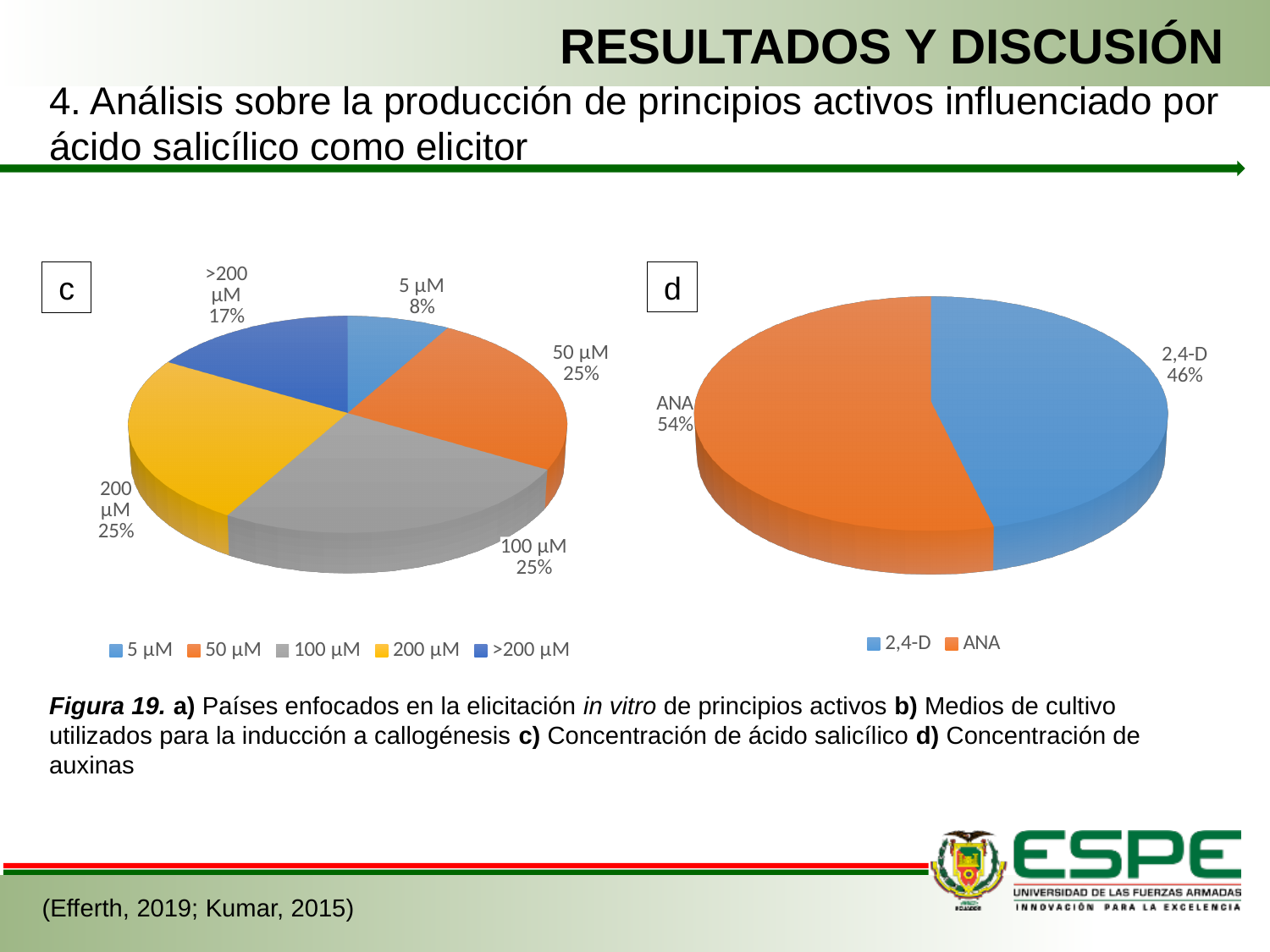
In the left pie chart (c), what share does the 5 µM slice have? 8% In the right pie chart (d), which auxin has the largest share? ANA In the right pie chart (d), what share does 2,4-D have? 46% In the left pie chart (c), which is larger, the share for >200 µM or the share for 5 µM? >200 µM In the left pie chart (c), what is the difference between the share for 100 µM and the share for >200 µM? 8% In the left pie chart (c), how many slices does the pie have? 5 In the right pie chart (d), what share does ANA have? 54% In the left pie chart (c), what kind of chart is shown? Pie chart In the left pie chart (c), which concentration has the smallest share? 5 µM In the right pie chart (d), how many entries does the legend list? 2 In the right pie chart (d), what is the difference between the ANA share and the 2,4-D share? 8% In the left pie chart (c), what share does the >200 µM slice have? 17%